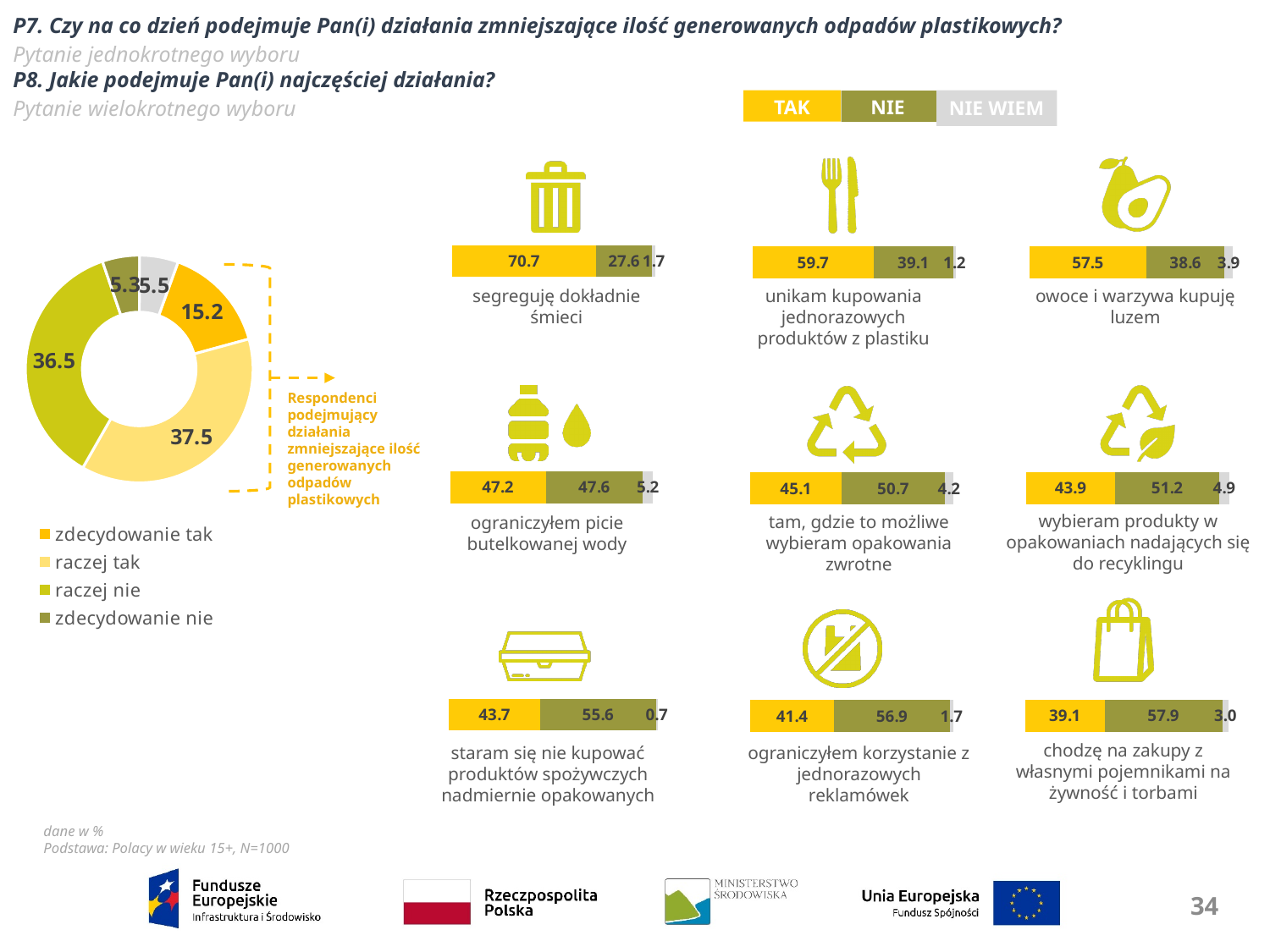
In the bar for "segreguję dokładnie śmieci", what is the TAK value? 70.7 In the donut chart on the left, what percentage of respondents answered "zdecydowanie tak"? 15.2 Among the nine action bars, which action has the highest TAK value? segreguję dokładnie śmieci In the bar for "ograniczyłem picie butelkowanej wody", what is the difference between the NIE and TAK values? 0.4 How many entries does the legend of the donut chart on the left list? 4 Among the nine action bars, which action has the lowest TAK value? chodzę na zakupy z własnymi pojemnikami na żywność i torbami How many series does the TAK / NIE / NIE WIEM legend for the action bars list? 3 In the bar for "chodzę na zakupy z własnymi pojemnikami na żywność i torbami", what is the NIE value? 57.9 Which has a higher TAK value: "unikam kupowania jednorazowych produktów z plastiku" or "owoce i warzywa kupuję luzem"? unikam kupowania jednorazowych produktów z plastiku In the donut chart on the left, which legend category has the largest slice? raczej tak What kind of chart is the chart on the left of the slide? Pie (donut) chart In the donut chart on the left, what percentage of respondents answered "raczej tak"? 37.5